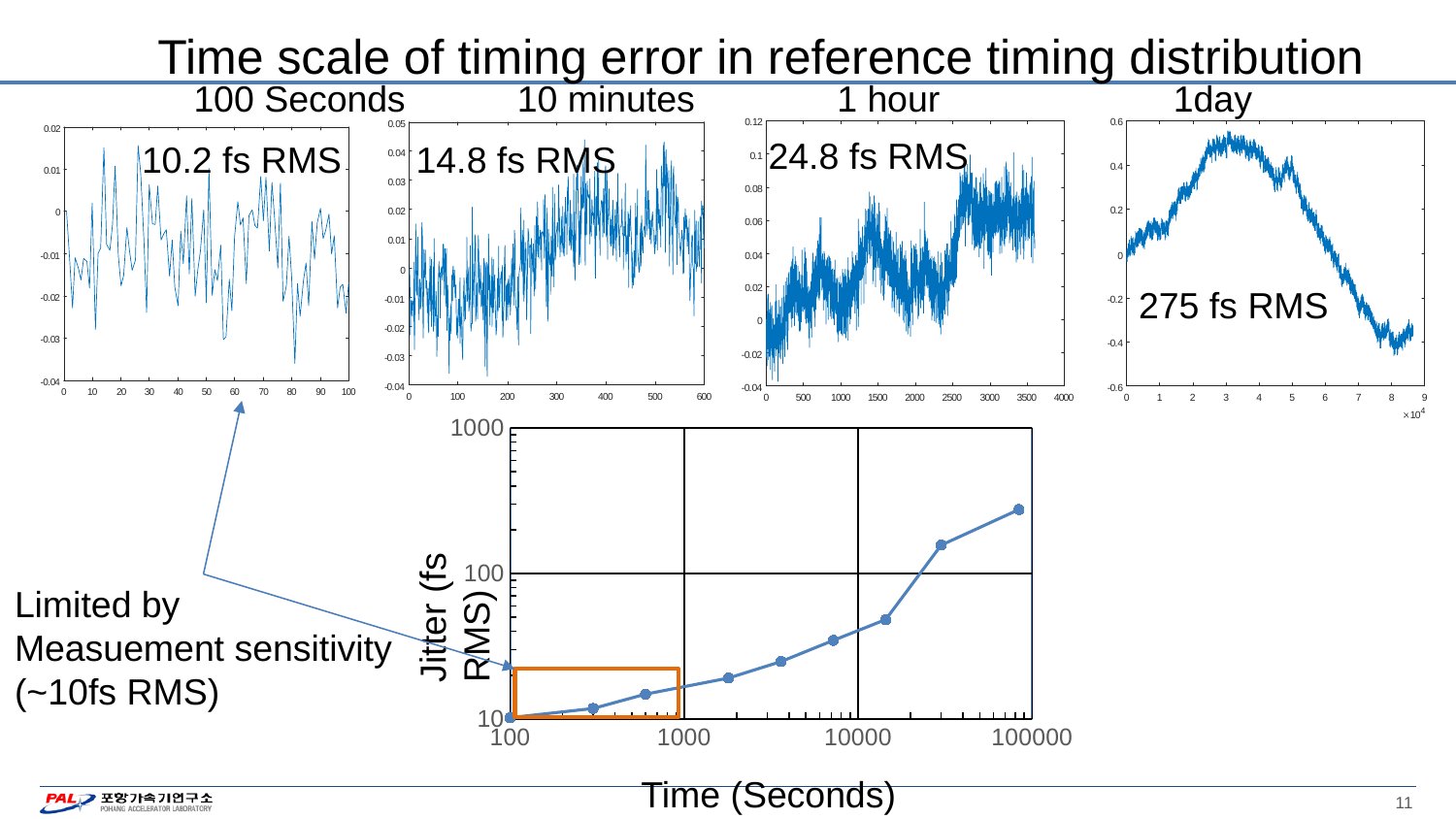
In the top plot labelled 1 hour, what RMS value is printed? 24.8 fs RMS Among the four top plots, which time scale has the lowest printed RMS value? 100 Seconds In the bottom chart of Jitter versus Time, is the jitter value of the rightmost point greater or less than 100? greater In the top-left plot labelled 100 Seconds, what RMS value is printed? 10.2 fs RMS What is the difference between the RMS value printed in the 1 hour plot and the RMS value printed in the 10 minutes plot? 10 fs In the top-right plot labelled 1day, what RMS value is printed? 275 fs RMS What is the y-axis label of the bottom chart? Jitter (fs RMS) Which has the larger printed RMS value, the 10 minutes plot or the 1 hour plot? 1 hour In the bottom chart of Jitter versus Time, does the jitter rise or fall as time increases? rises In the top plot labelled 10 minutes, what RMS value is printed? 14.8 fs RMS Among the four top plots, which time scale has the highest printed RMS value? 1day What kind of chart is the bottom chart of Jitter versus Time? line chart